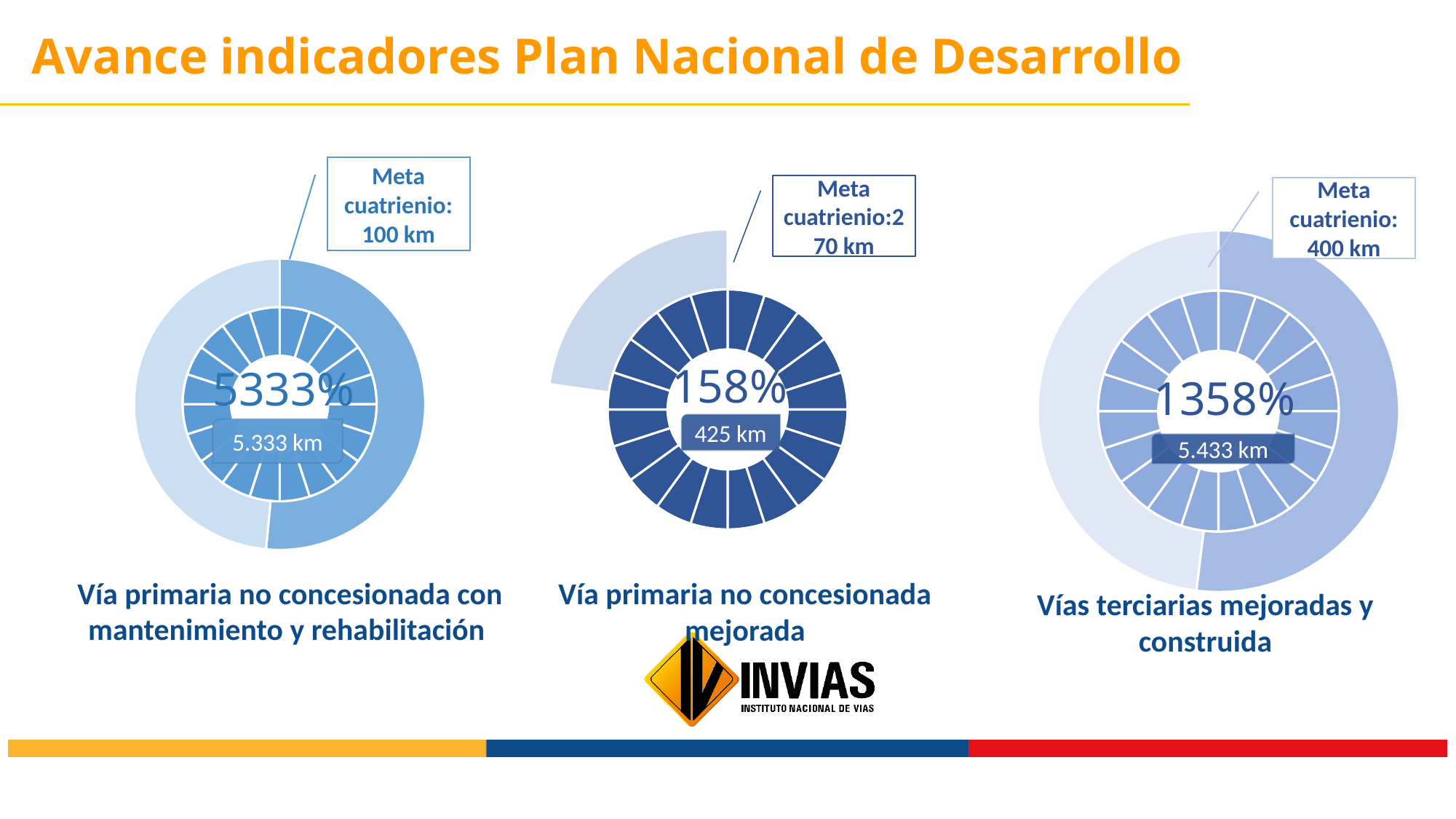
In the chart titled 'Vía primaria no concesionada mejorada', how many km are reported as achieved? 425 km What percentage is shown in the centre of the chart titled 'Vía primaria no concesionada con mantenimiento y rehabilitación'? 5333% How many charts are shown on the slide? 3 What is the 'Meta cuatrienio' for the chart titled 'Vías terciarias mejoradas y construida'? 400 km In the chart titled 'Vía primaria no concesionada mejorada', by how many km does the achieved value exceed the 'Meta cuatrienio'? 155 km What percentage is shown in the centre of the chart titled 'Vías terciarias mejoradas y construida'? 1358% Which of the three charts shows the highest percentage of progress? Vía primaria no concesionada con mantenimiento y rehabilitación What percentage is shown in the centre of the chart titled 'Vía primaria no concesionada mejorada'? 158% In the chart titled 'Vía primaria no concesionada con mantenimiento y rehabilitación', how many km are reported as achieved? 5.333 km Which of the three charts shows the lowest percentage of progress? Vía primaria no concesionada mejorada In the chart titled 'Vías terciarias mejoradas y construida', how many km are reported as achieved? 5.433 km What is the 'Meta cuatrienio' for the chart titled 'Vía primaria no concesionada mejorada'? 270 km